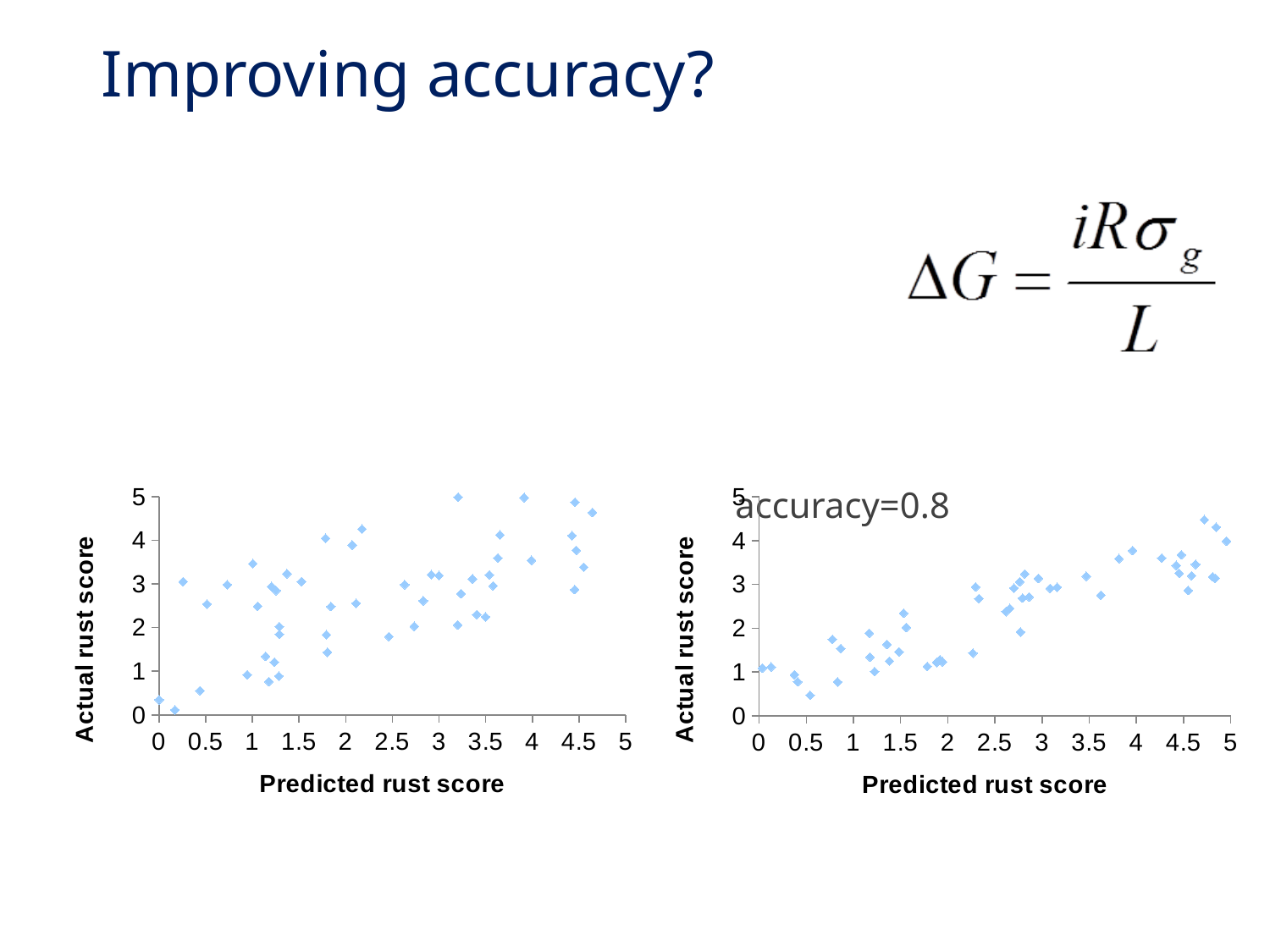
In the left chart, is the highest actual rust score greater or less than 4? greater In the left chart, do the actual rust scores generally rise or fall as the predicted rust score increases? rise What kind of chart is the left chart on the slide? scatter chart In the right chart, is the highest actual rust score greater or less than 4? greater How many charts are shown on the slide? 2 In the right chart, what accuracy value is printed above the plot? accuracy=0.8 In the left chart, is the lowest actual rust score greater or less than 1? less In the left chart, what is the label of the x axis? Predicted rust score In the right chart, do the actual rust scores generally rise or fall as the predicted rust score increases? rise What kind of chart is the right chart on the slide? scatter chart